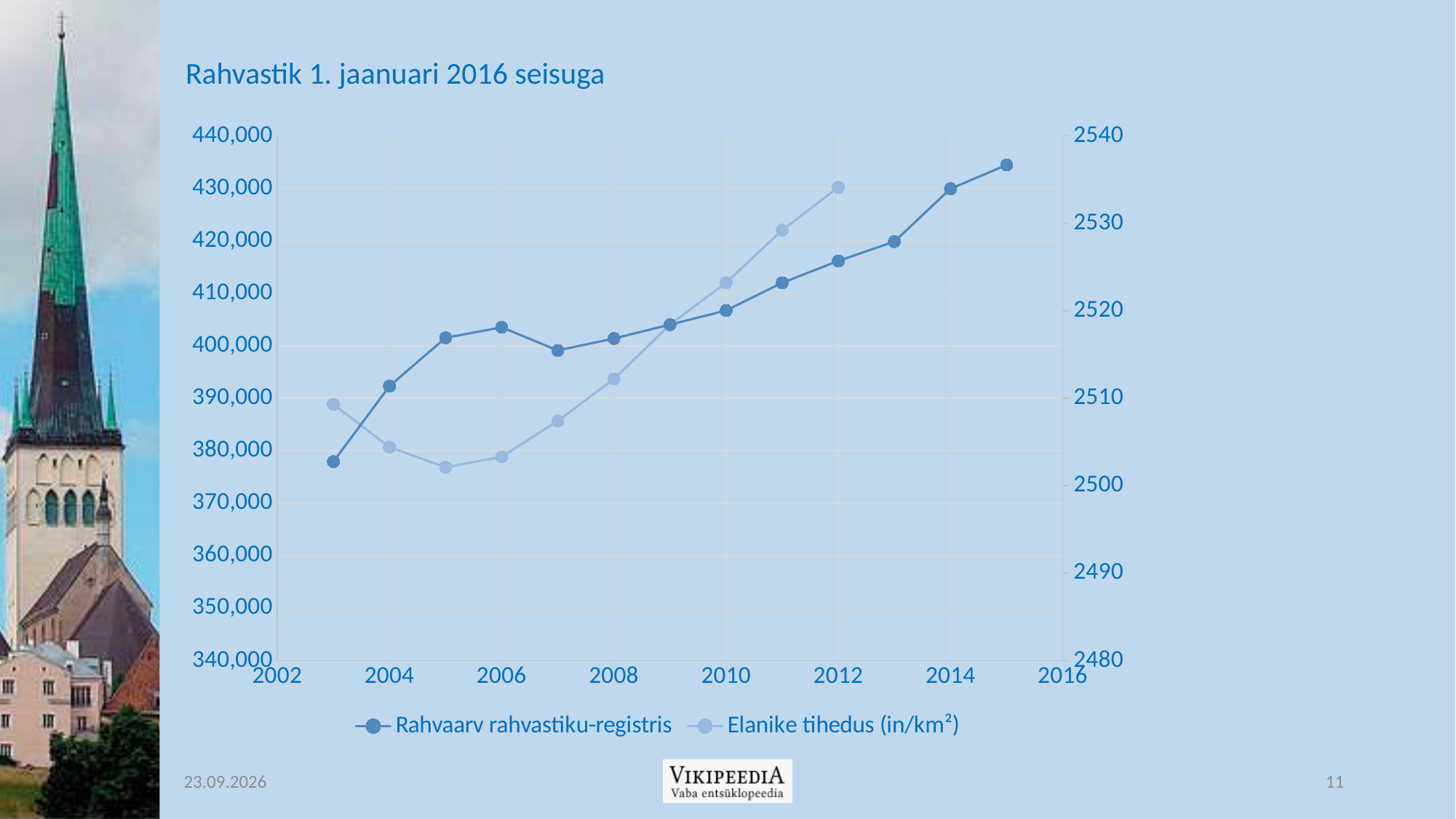
Which is larger, the value of Rahvaarv rahvastiku-registris in 2006 or in 2007? 2006 In which year is the value of Elanike tihedus (in/km²) highest? 2012 How many series does the legend list? 2 Is the value for Rahvaarv rahvastiku-registris in 2003 greater or less than 380,000? less Which series is plotted in the lighter blue colour? Elanike tihedus (in/km²) In which year is the value of Rahvaarv rahvastiku-registris lowest? 2003 How many data points does the Rahvaarv rahvastiku-registris series have? 13 In which year is the value of Rahvaarv rahvastiku-registris highest? 2015 What kind of chart is shown on the slide? line chart What is the title of the slide containing the chart? Rahvastik 1. jaanuari 2016 seisuga Is the value for Elanike tihedus (in/km²) in 2009 greater or less than 2510? greater Is the value for Rahvaarv rahvastiku-registris in 2015 greater or less than 430,000? greater